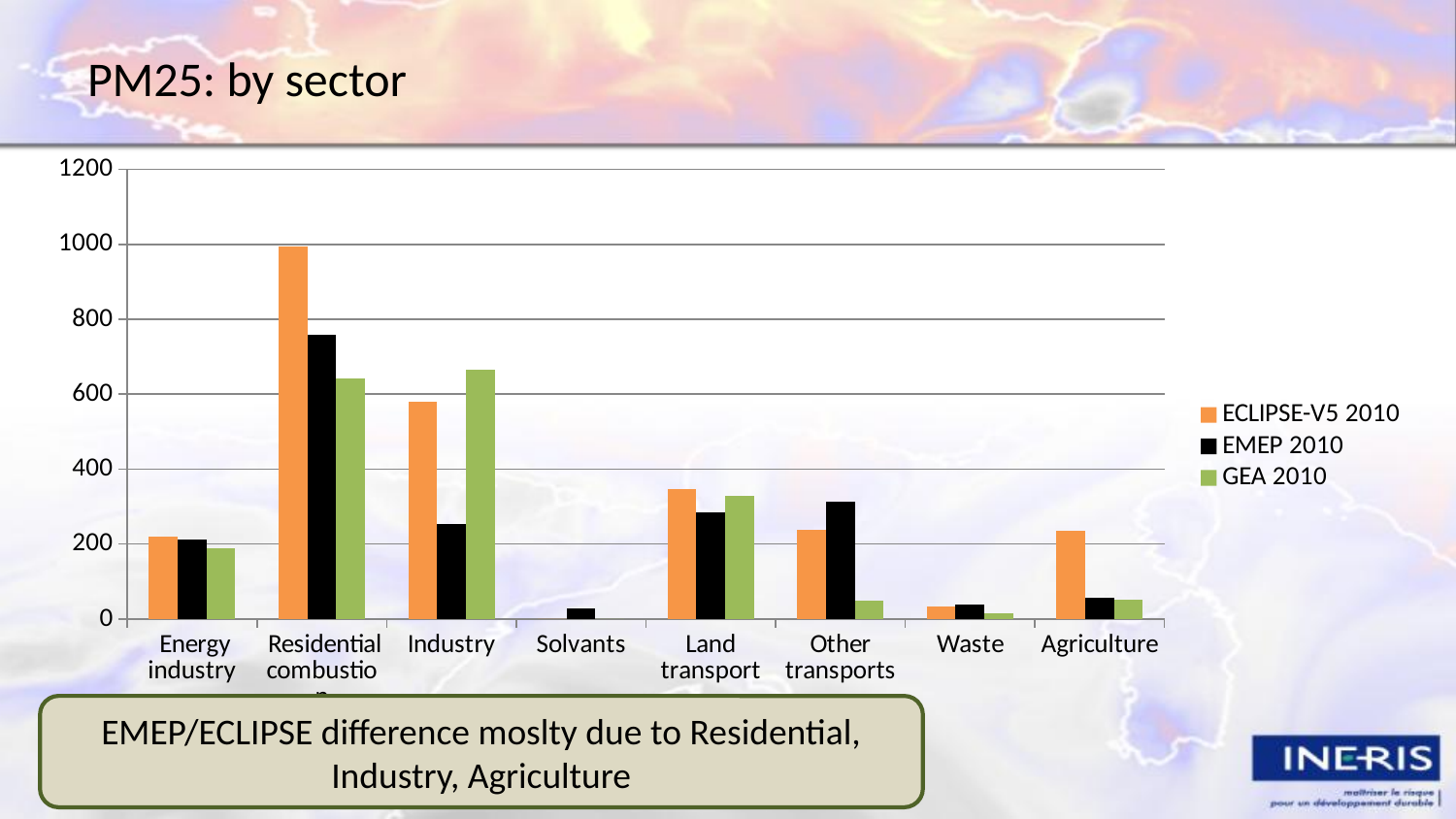
Which sector has the highest EMEP 2010 value? Residential combustion What colour represents the GEA 2010 series in the legend? green Which sector has the highest ECLIPSE-V5 2010 value? Residential combustion Is the ECLIPSE-V5 2010 value for Residential combustion greater or less than 800? greater Which sector has the highest GEA 2010 value? Industry How many series does the legend list? 3 What kind of chart is shown on the slide? bar chart For Other transports, which is larger: the EMEP 2010 value or the GEA 2010 value? EMEP 2010 Is the GEA 2010 value for Industry greater or less than 600? greater How many sector categories are shown on the x axis? 8 For Industry, which is larger: the ECLIPSE-V5 2010 value or the EMEP 2010 value? ECLIPSE-V5 2010 Is the EMEP 2010 value for Residential combustion greater or less than 600? greater